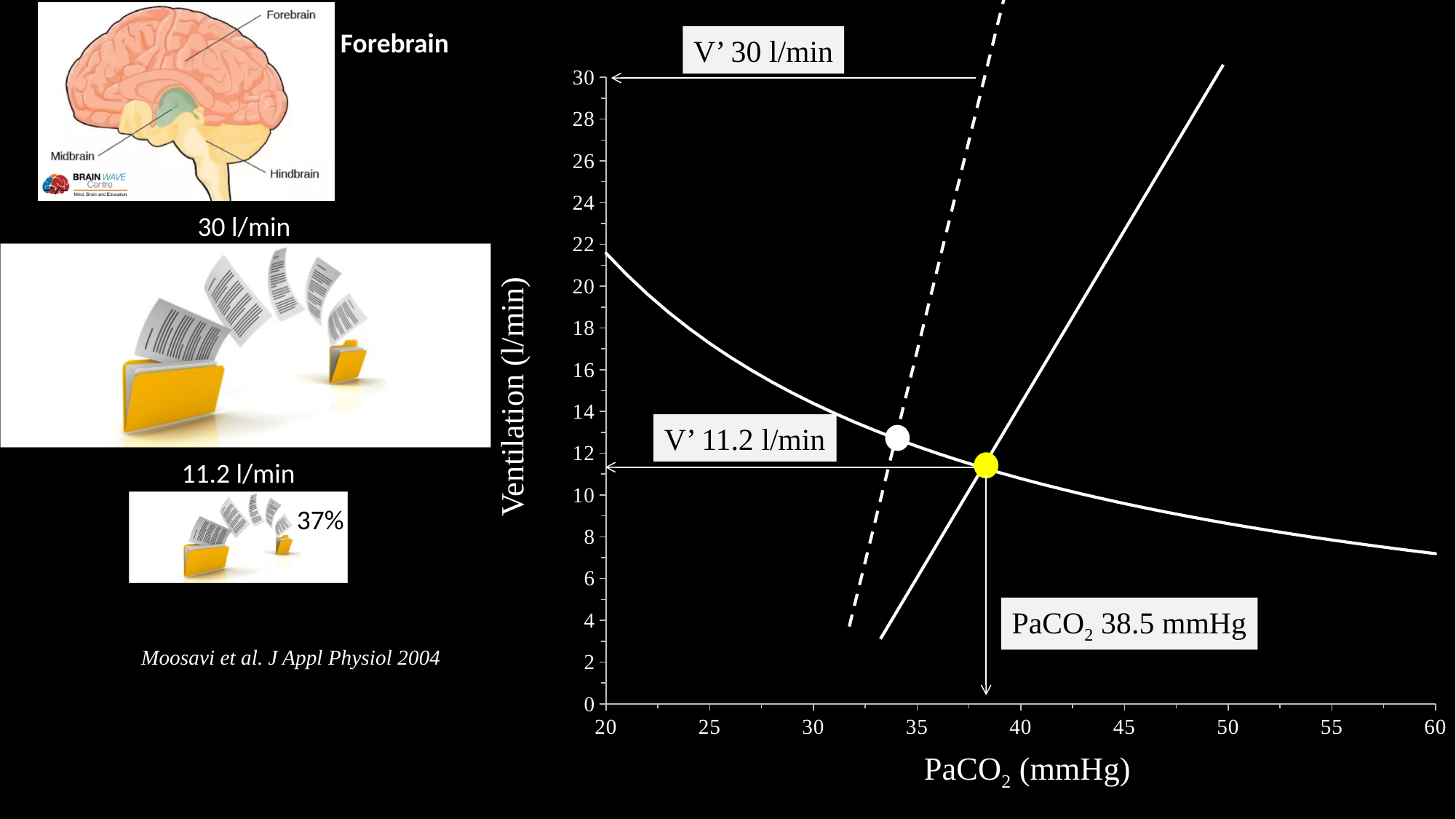
Is the ventilation value of the curved line at PaCO2 60 mmHg greater or less than 8? less What kind of chart is shown on the slide? line chart What ventilation value is labelled at the yellow point where the two solid lines intersect? V' 11.2 l/min What is the label of the x axis of the chart? PaCO2 (mmHg) Does the curved line rise or fall as PaCO2 increases along the x axis? fall Is the ventilation value of the curved line at PaCO2 20 mmHg greater or less than 20? greater What is the highest value shown on the y axis of the chart? 30 Is the ventilation value at the white point greater or less than 14? less Does the solid straight line rise or fall as PaCO2 increases along the x axis? rise What PaCO2 value is labelled at the yellow intersection point? PaCO2 38.5 mmHg What ventilation value is labelled where the dashed line reaches the top of the chart? V' 30 l/min What is the label of the y axis of the chart? Ventilation (l/min)